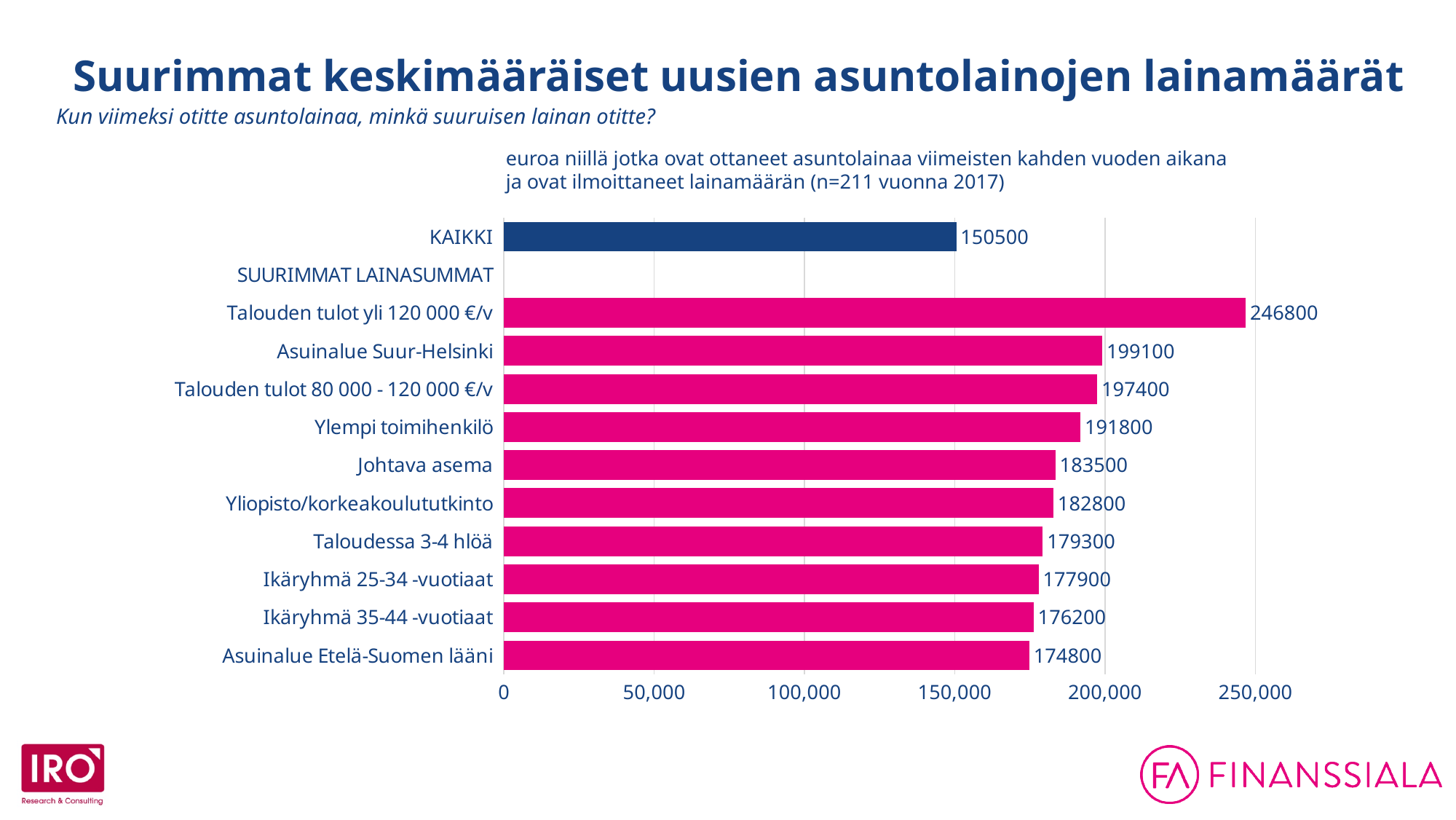
What is the difference between the values for Asuinalue Suur-Helsinki and Asuinalue Etelä-Suomen lääni? 24300 What is the value for Asuinalue Suur-Helsinki? 199100 What kind of chart is shown on the slide? bar chart What is the difference between the values for Talouden tulot yli 120 000 €/v and KAIKKI? 96300 Which category has the lowest value? KAIKKI How many bars with values are plotted in the chart? 11 Which is larger, the value for Ylempi toimihenkilö or the value for Johtava asema? Ylempi toimihenkilö Is the value for Taloudessa 3-4 hlöä greater or less than 150,000? greater Which category has the highest value? Talouden tulot yli 120 000 €/v What is the value for Ikäryhmä 35-44 -vuotiaat? 176200 What is the value for Talouden tulot yli 120 000 €/v? 246800 What is the value for KAIKKI? 150500